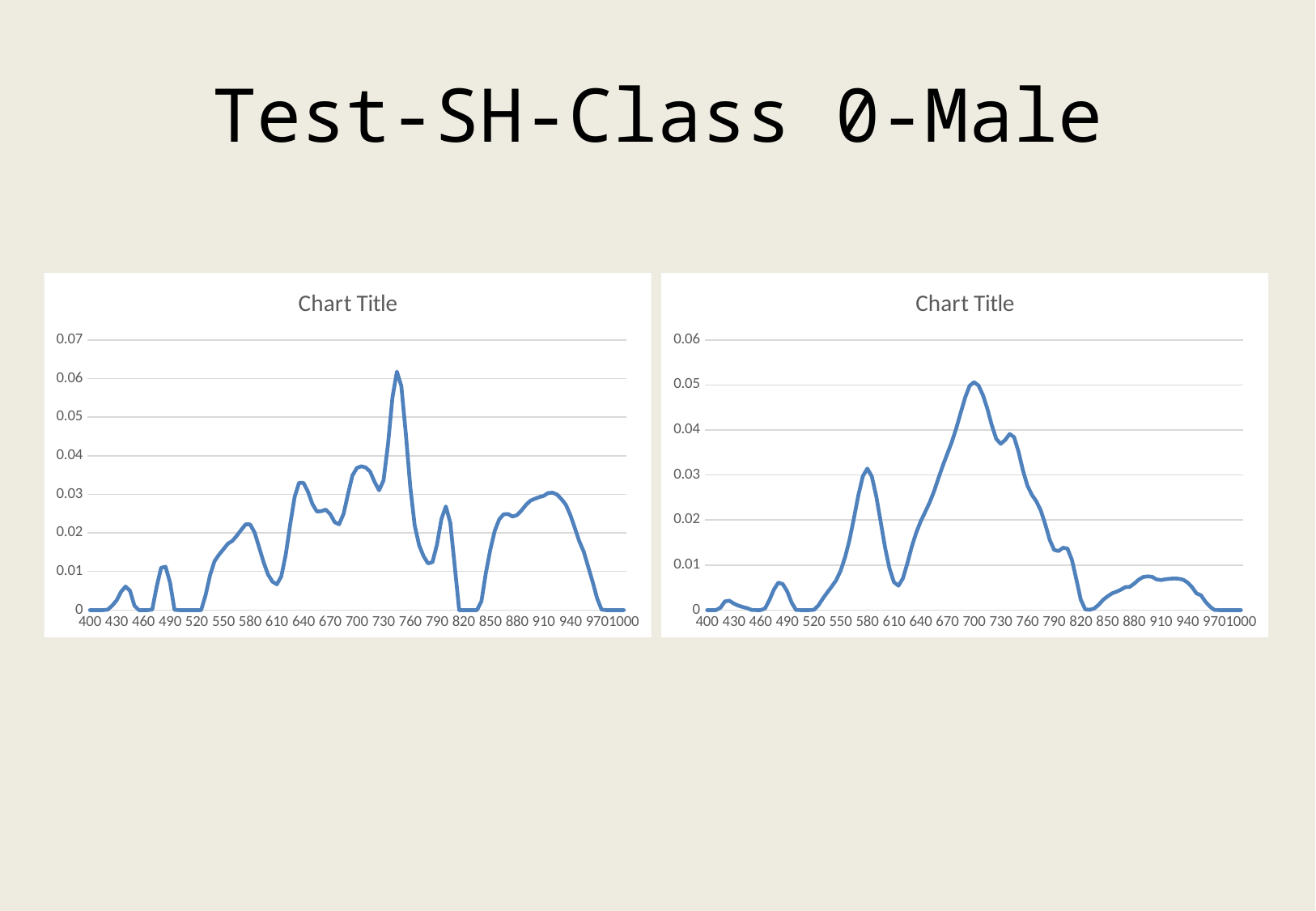
What is the highest value labelled on the y axis of the right chart? 0.06 In the right chart, is the value at 910 greater or less than 0.01? less In the left chart, what is the value of the line at 400? 0 In the left chart, is the value at 610 greater or less than 0.01? less In the right chart, around which x-axis label does the line reach its highest point? 700 In the right chart, is the value at 580 greater or less than 0.02? greater What kind of chart is the chart on the left of the slide? line chart What kind of chart is the chart on the right of the slide? line chart In the right chart, what is the value of the line at 1000? 0 What is the title shown above the left chart? Chart Title In the right chart, which is larger: the value at 700 or the value at 580? 700